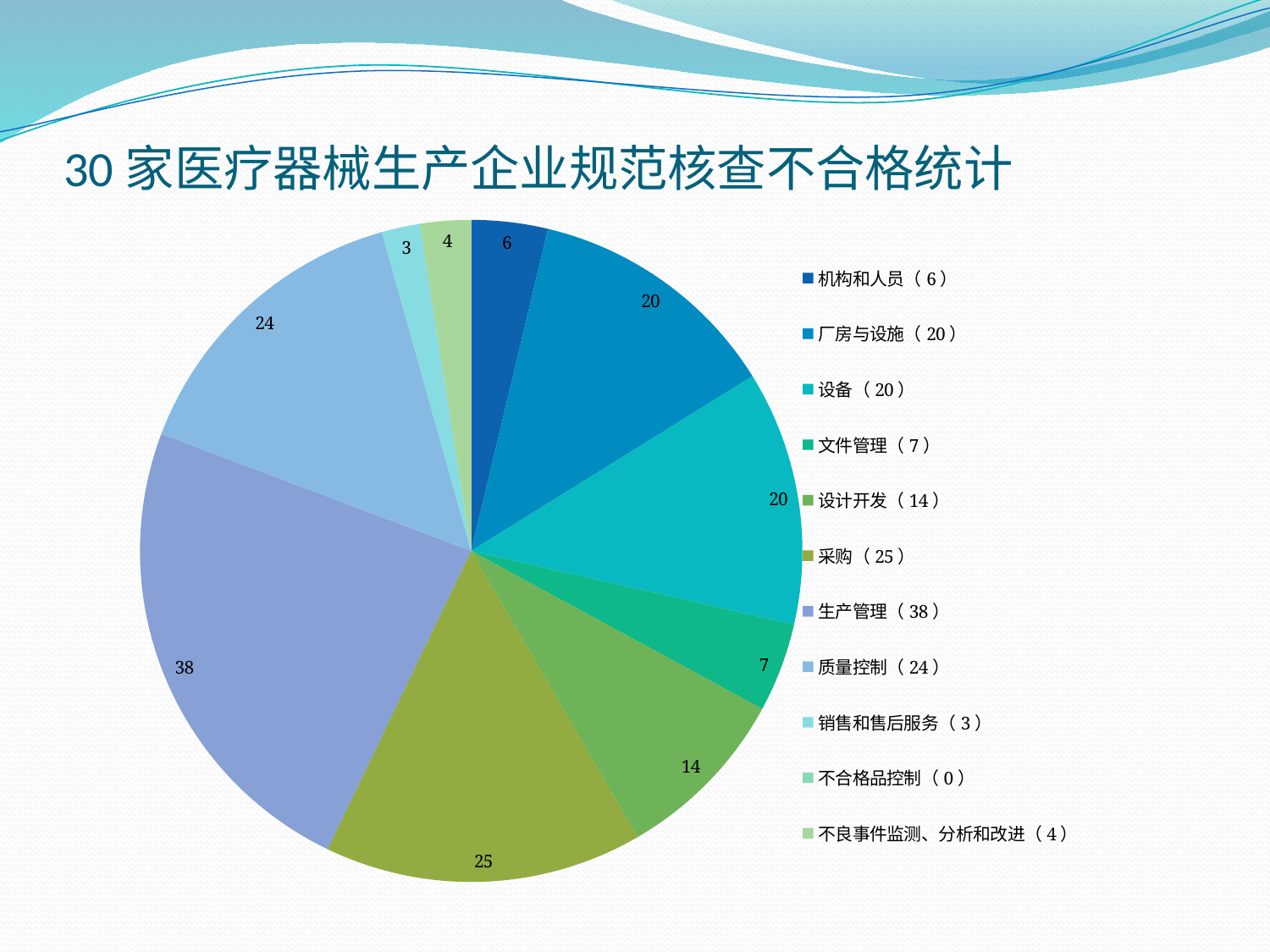
Which category has the largest value? 生产管理 What is the value for 采购? 25 What is the value for 生产管理? 38 What kind of chart is shown on the slide? pie chart How many categories does the legend list? 11 What is the title of the slide? 30 家医疗器械生产企业规范核查不合格统计 What is the value for 不良事件监测、分析和改进? 4 What is the difference between the values for 生产管理 and 质量控制? 14 What is the value for 销售和售后服务? 3 What is the total of all the values shown in the chart? 161 Which category has the smallest value? 不合格品控制 Which is larger, the value for 采购 or the value for 设计开发? 采购